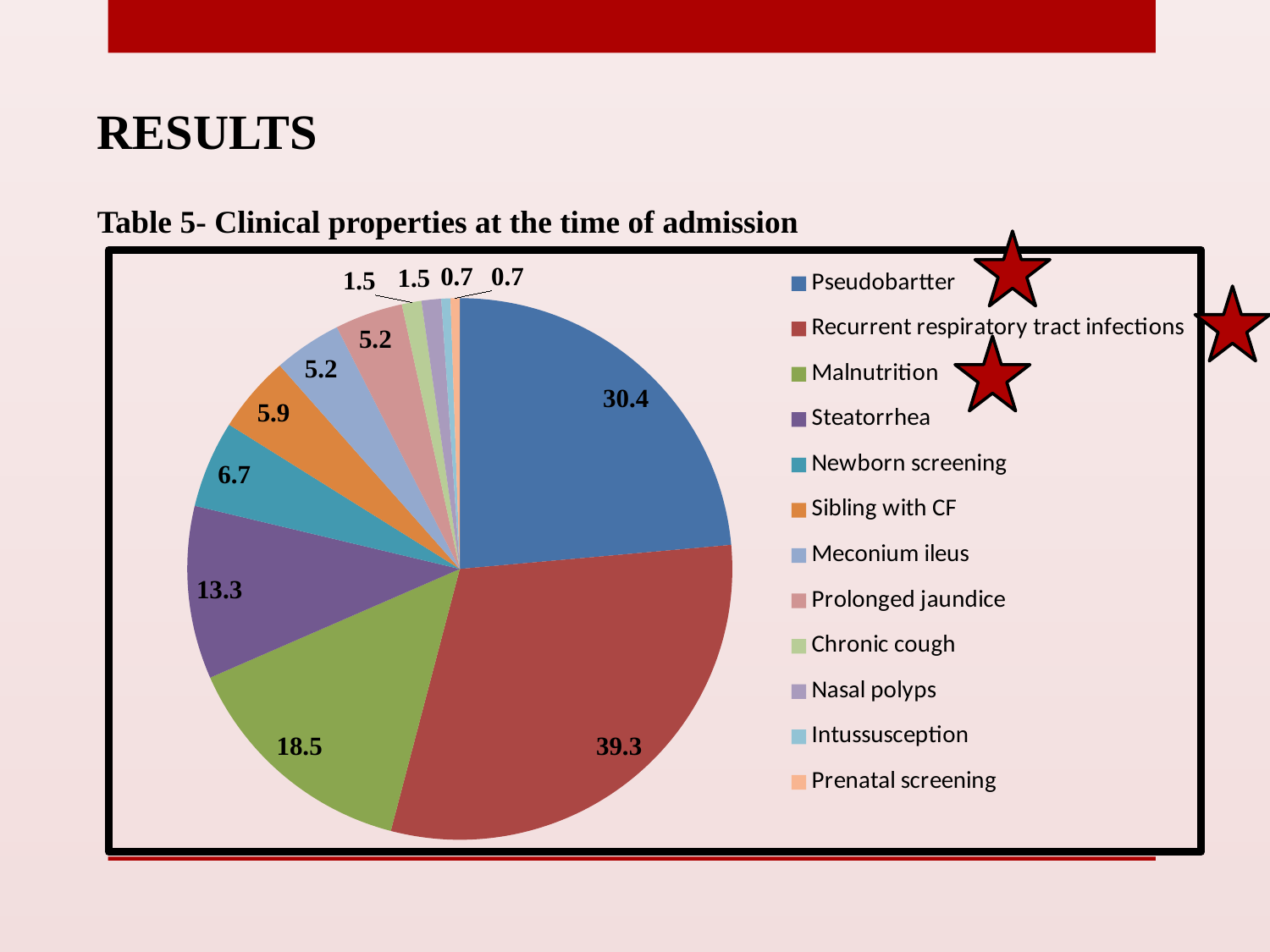
What is the value shown for Newborn screening? 6.7 What is the difference between the values for Recurrent respiratory tract infections and Pseudobartter? 8.9 What is the value shown for Steatorrhea? 13.3 What is the value shown for Pseudobartter? 30.4 What is the value shown for Sibling with CF? 5.9 Which is larger, the value for Malnutrition or the value for Steatorrhea? Malnutrition How many categories does the pie chart have? 12 What is the title given above the chart? Table 5- Clinical properties at the time of admission What type of chart is shown on the slide? Pie chart Which category has the largest slice of the pie? Recurrent respiratory tract infections What is the value shown for Recurrent respiratory tract infections? 39.3 What is the value shown for Malnutrition? 18.5